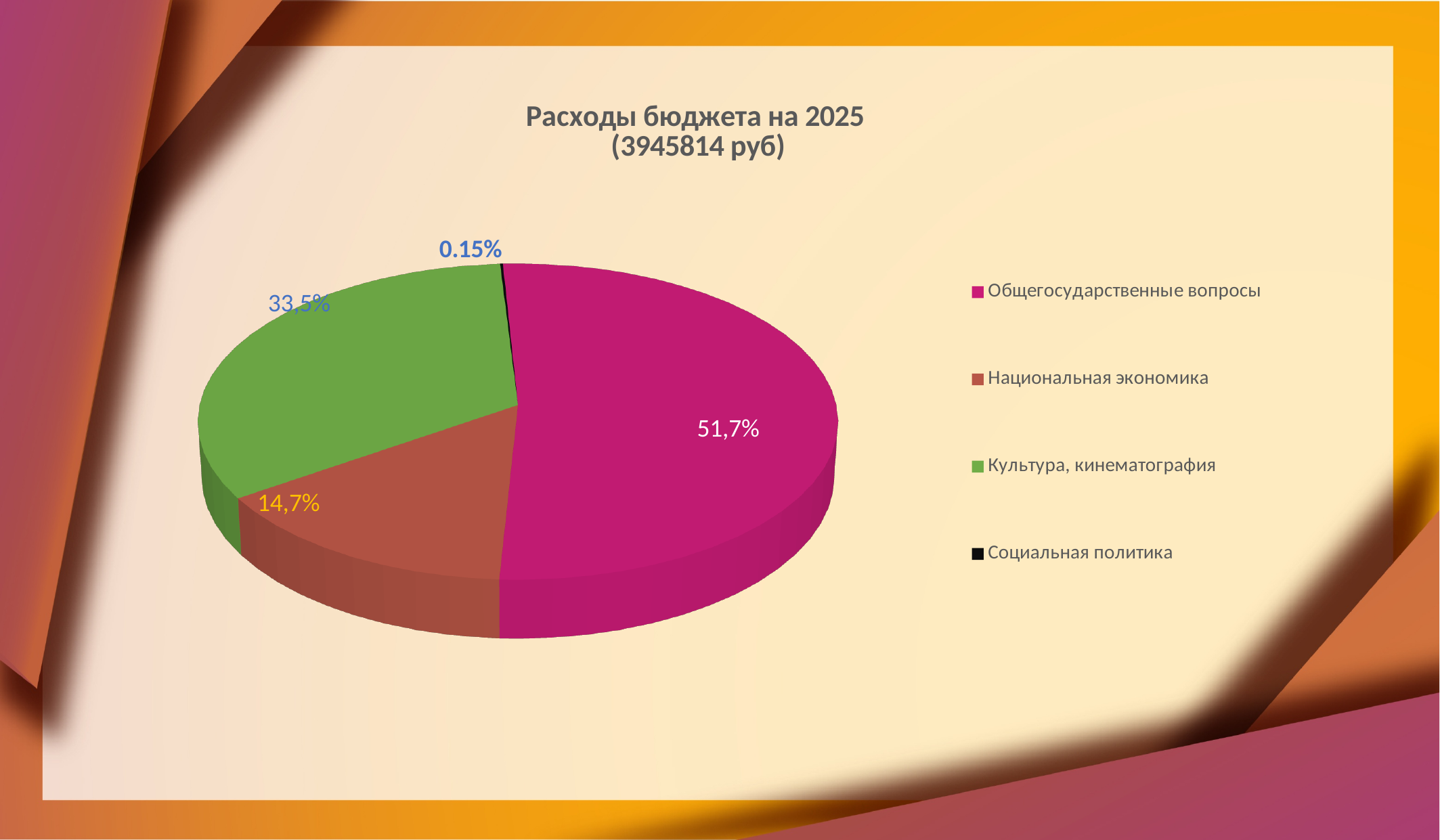
How many categories does the pie chart have? 4 What share of the pie does Общегосударственные вопросы take? 51,7% What is the title of the chart? Расходы бюджета на 2025 (3945814 руб) What kind of chart is shown on the slide? Pie chart What share of the pie does Культура, кинематография take? 33,5% What is the difference in percentage points between the shares of Общегосударственные вопросы and Культура, кинематография? 18,2 What share of the pie does Национальная экономика take? 14,7% Which category has the largest share of the pie? Общегосударственные вопросы What colour is the slice for Культура, кинематография? Green Which category has the smallest share of the pie? Социальная политика Which is larger: the share for Культура, кинематография or the share for Национальная экономика? Культура, кинематография